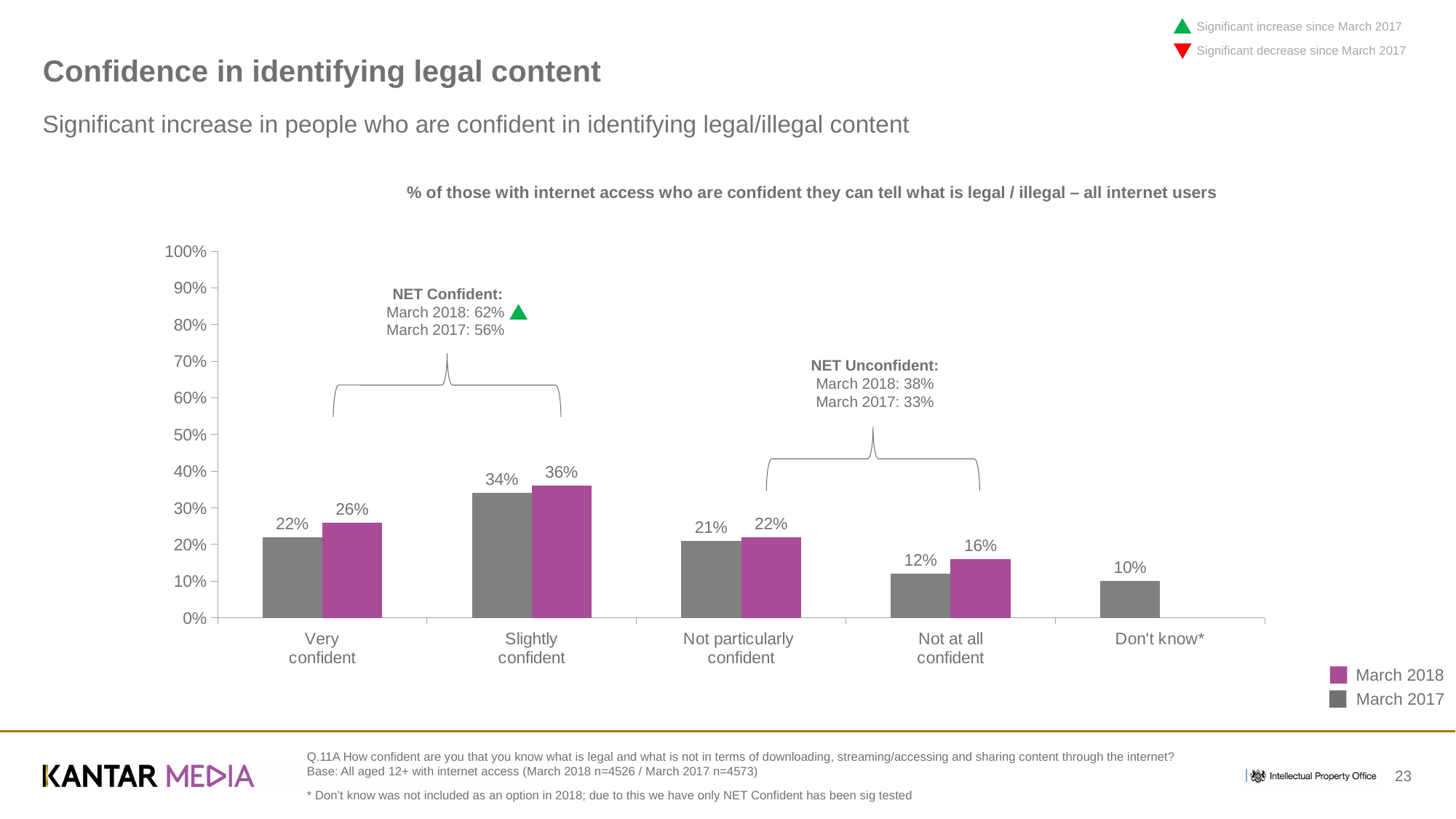
Which is larger for Not at all confident: the March 2018 value or the March 2017 value? March 2018 Which colour represents March 2018 in the legend? Purple What is the March 2018 value for Not at all confident? 16% What is the March 2017 value for Don't know*? 10% What is the March 2017 value for Very confident? 22% What is the difference between the March 2018 and March 2017 values for Very confident? 4% How many categories are shown on the x axis? 5 How many series does the legend list? 2 What kind of chart is shown on the slide? Bar chart Which category has the highest March 2018 value? Slightly confident What is the March 2018 value for Slightly confident? 36% Which category has the lowest March 2017 value? Don't know*